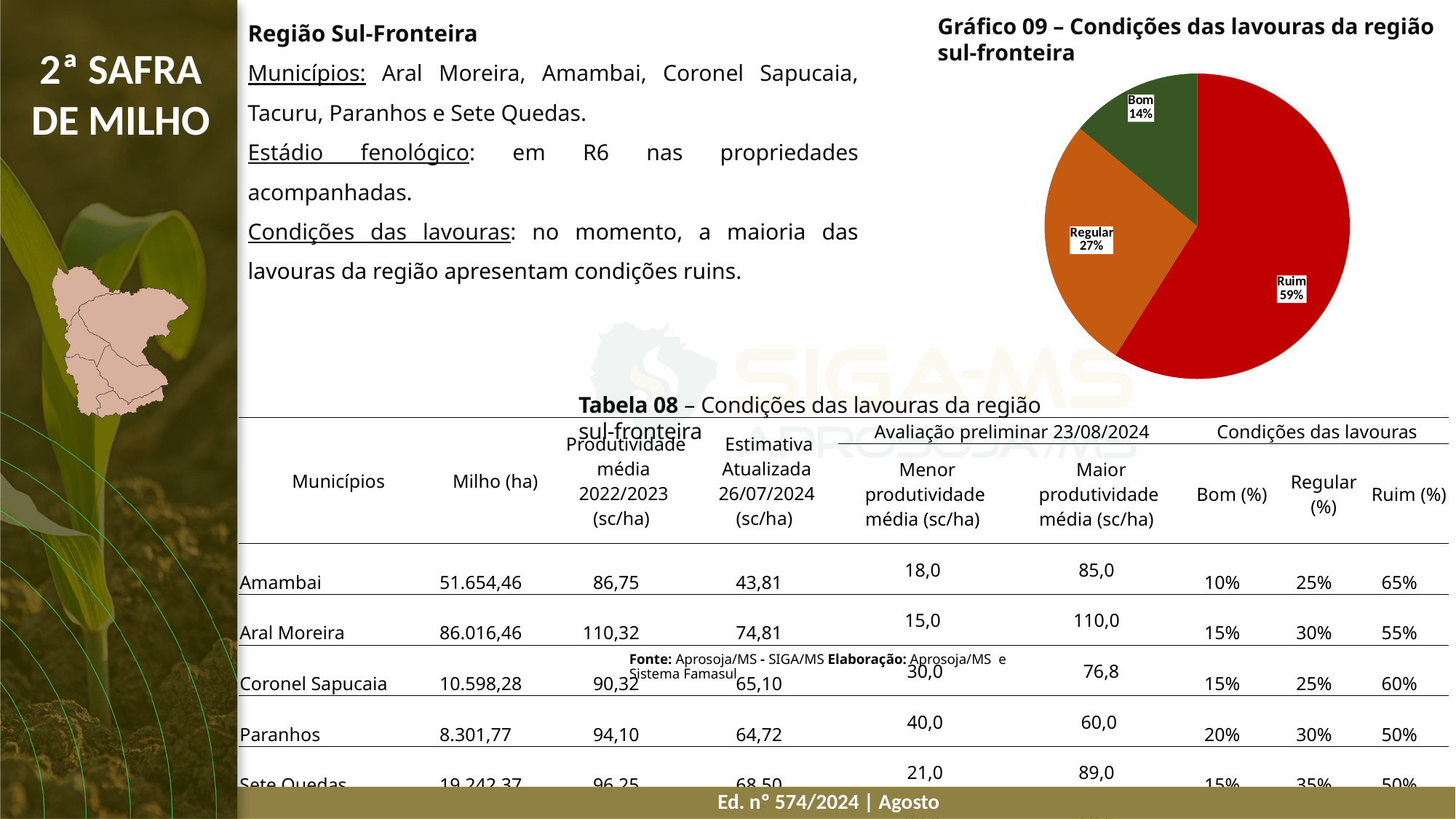
In Gráfico 09, how many percentage points larger is the Regular slice than the Bom slice? 13 How many slices does the pie in Gráfico 09 have? 3 What kind of chart is Gráfico 09? pie chart Which category has the smallest slice in Gráfico 09? Bom In Gráfico 09, which slice is larger: Regular or Bom? Regular Which category has the largest slice in Gráfico 09? Ruim In Gráfico 09, what share of the lavouras is classified as Regular? 27% In Gráfico 09, what colour is the Ruim slice? red In Gráfico 09, what share of the lavouras is classified as Bom? 14% In Gráfico 09, what share of the lavouras is classified as Ruim? 59% What is the title of the pie chart on the slide? Gráfico 09 – Condições das lavouras da região sul-fronteira In Gráfico 09, how many percentage points larger is the Ruim slice than the Regular slice? 32